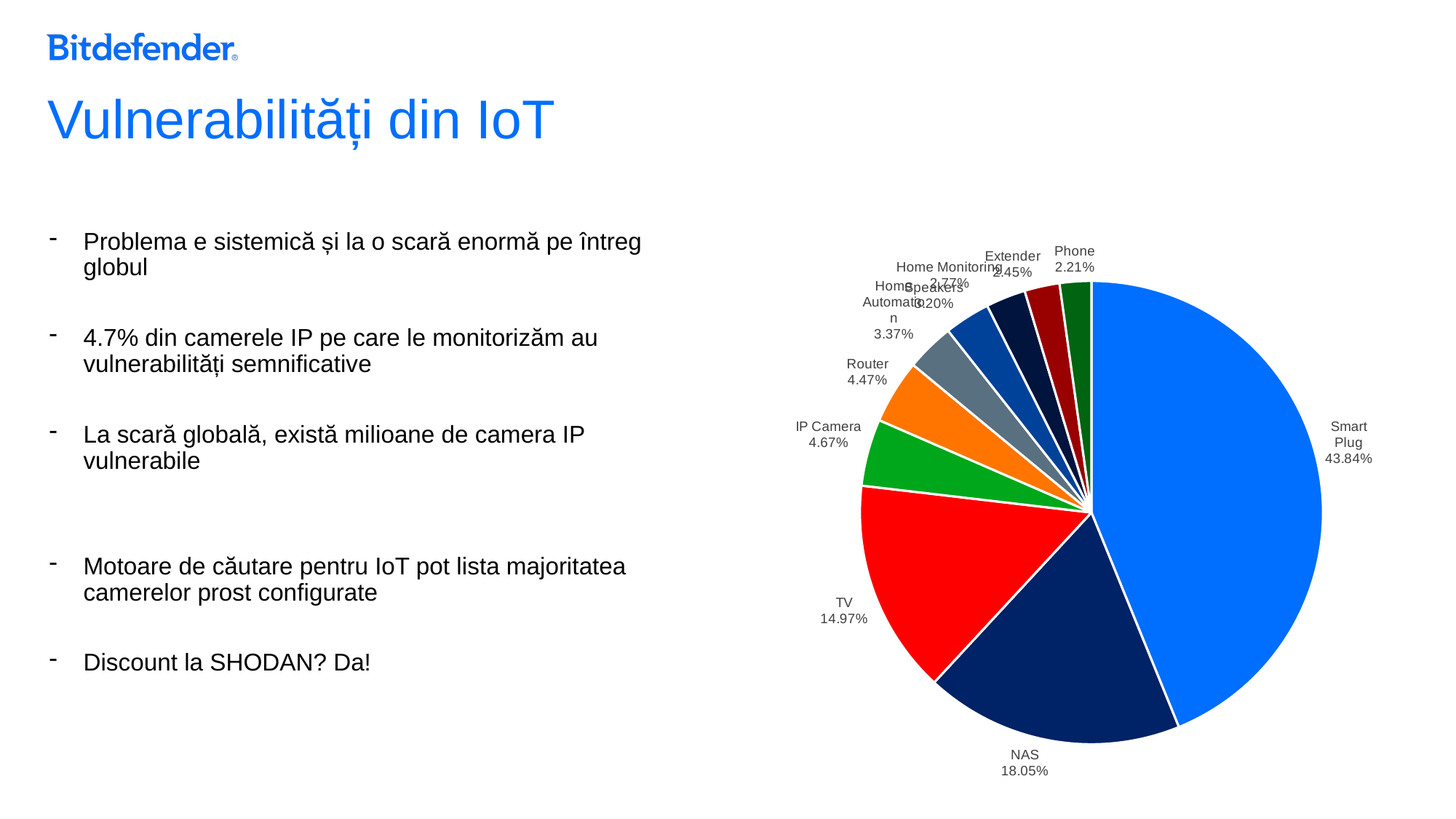
Which category has the largest slice of the pie? Smart Plug What is the value shown for Router? 4.47% Which category has the smallest slice of the pie? Phone What share of the pie does Smart Plug have? 43.84% How many slices does the pie chart have? 10 Which is larger, the share for NAS or the share for TV? NAS What is the value shown for NAS? 18.05% What is the value shown for Phone? 2.21% What kind of chart is shown on the slide? pie chart What is the difference between the NAS and TV shares? 3.08% What is the value shown for TV? 14.97% What is the value shown for IP Camera? 4.67%